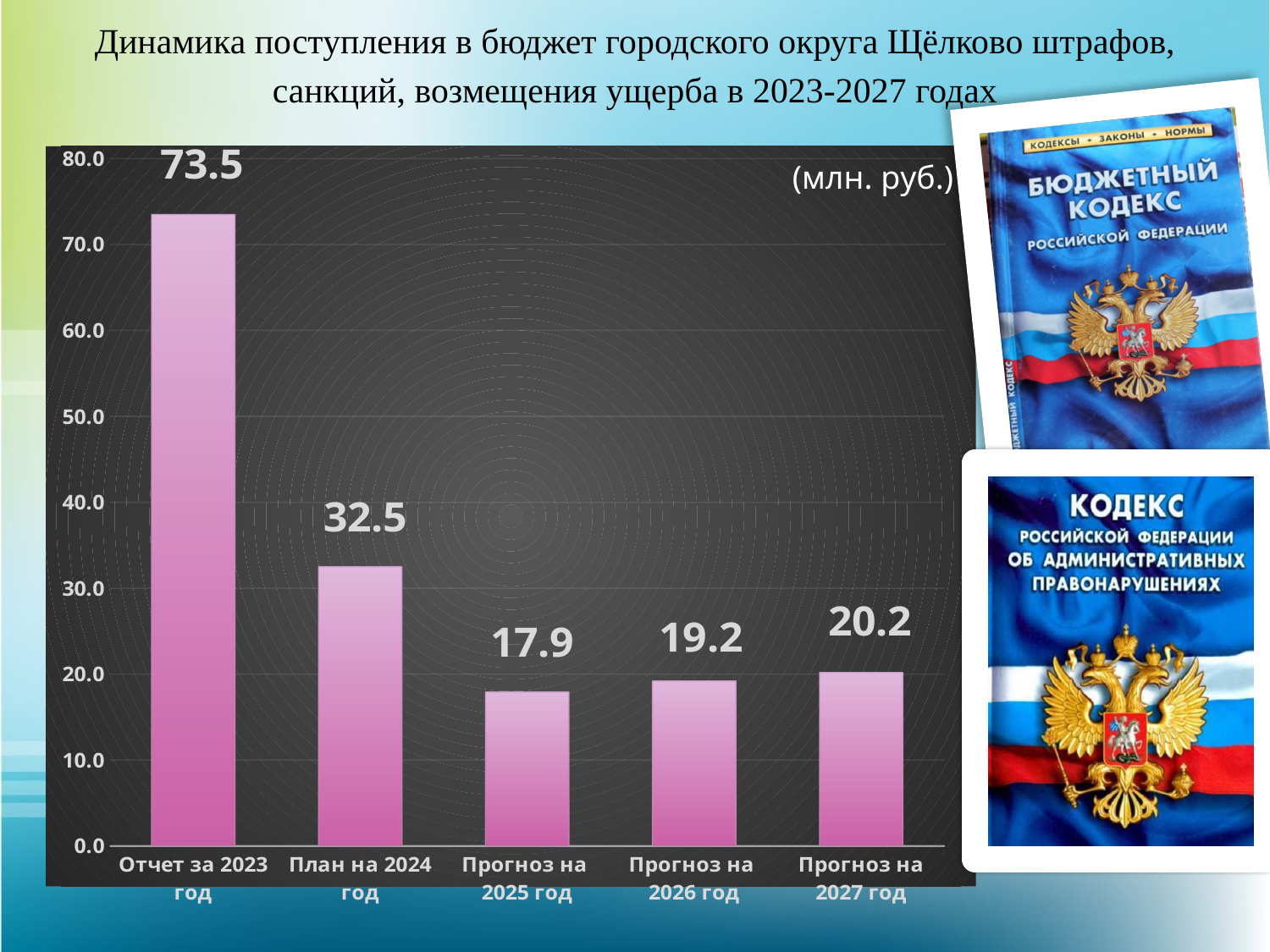
Which category has the lowest value? Прогноз на 2025 год Which category has the highest value? Отчет за 2023 год How many categories are shown on the chart? 5 What is the value for "Прогноз на 2025 год"? 17.9 What is the difference between the values for "Отчет за 2023 год" and "План на 2024 год"? 41.0 What is the value for "План на 2024 год"? 32.5 Is the value for "План на 2024 год" greater or less than 40.0? less What unit is indicated for the values on the chart? млн. руб. What is the value for "Отчет за 2023 год"? 73.5 What kind of chart is shown on the slide? bar chart Which is larger, the value for "Прогноз на 2026 год" or "Прогноз на 2027 год"? Прогноз на 2027 год What is the value for "Прогноз на 2027 год"? 20.2